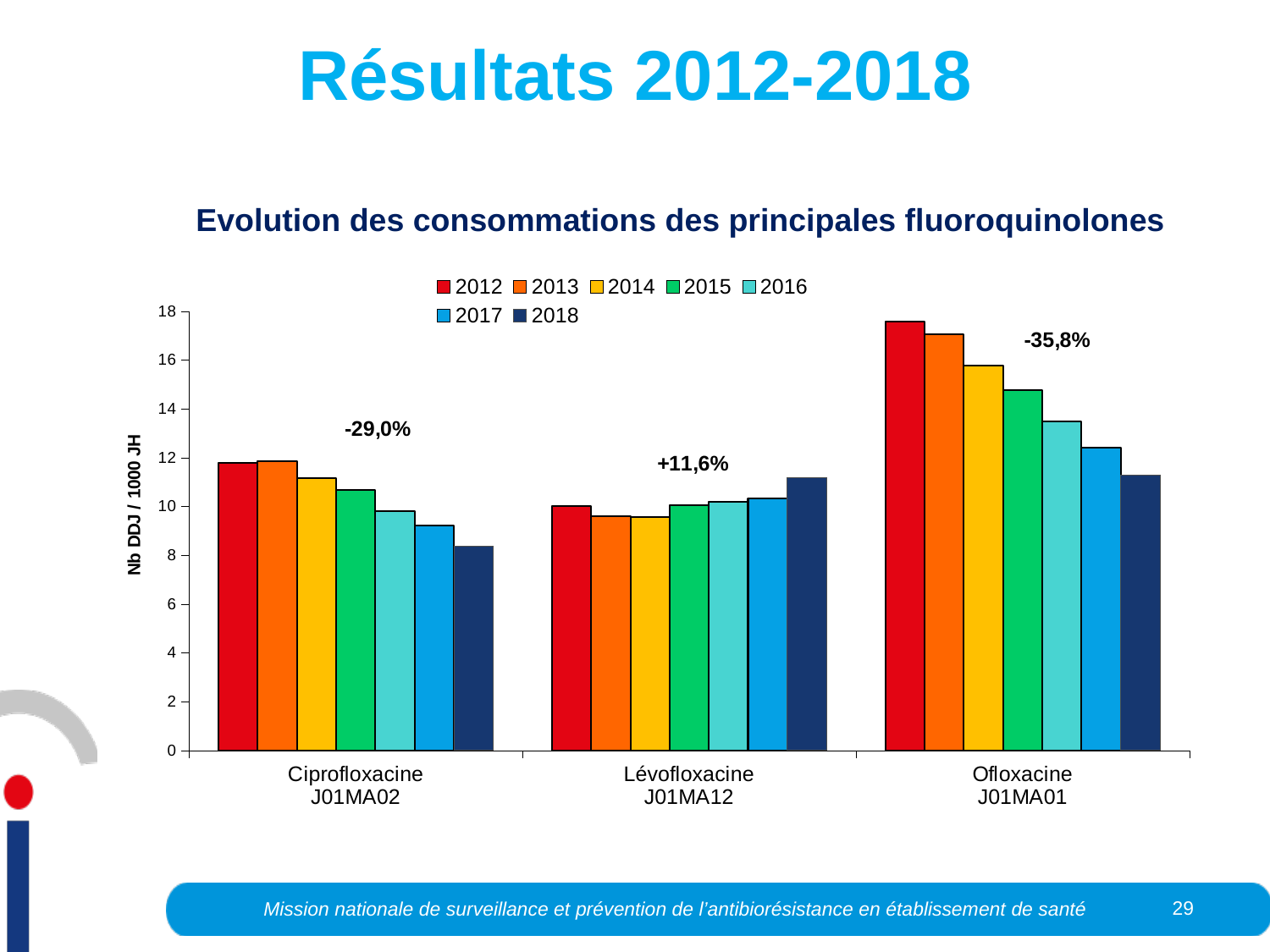
What percentage change is annotated above the Lévofloxacine J01MA12 group? +11,6% How many series does the legend list? 7 Is the 2012 value for Ofloxacine J01MA01 greater or less than 16? greater Which antibiotic has the lowest 2018 value? Ciprofloxacine J01MA02 What is the label of the y axis? Nb DDJ / 1000 JH Do the values for Lévofloxacine J01MA12 rise or fall from 2014 to 2018? rise What percentage change is annotated above the Ofloxacine J01MA01 group? -35,8% What percentage change is annotated above the Ciprofloxacine J01MA02 group? -29,0% Which antibiotic has the highest 2012 value? Ofloxacine J01MA01 Is the 2018 value for Ciprofloxacine J01MA02 greater or less than 10? less How many antibiotic categories are shown on the x axis? 3 What kind of chart is shown on the slide? bar chart